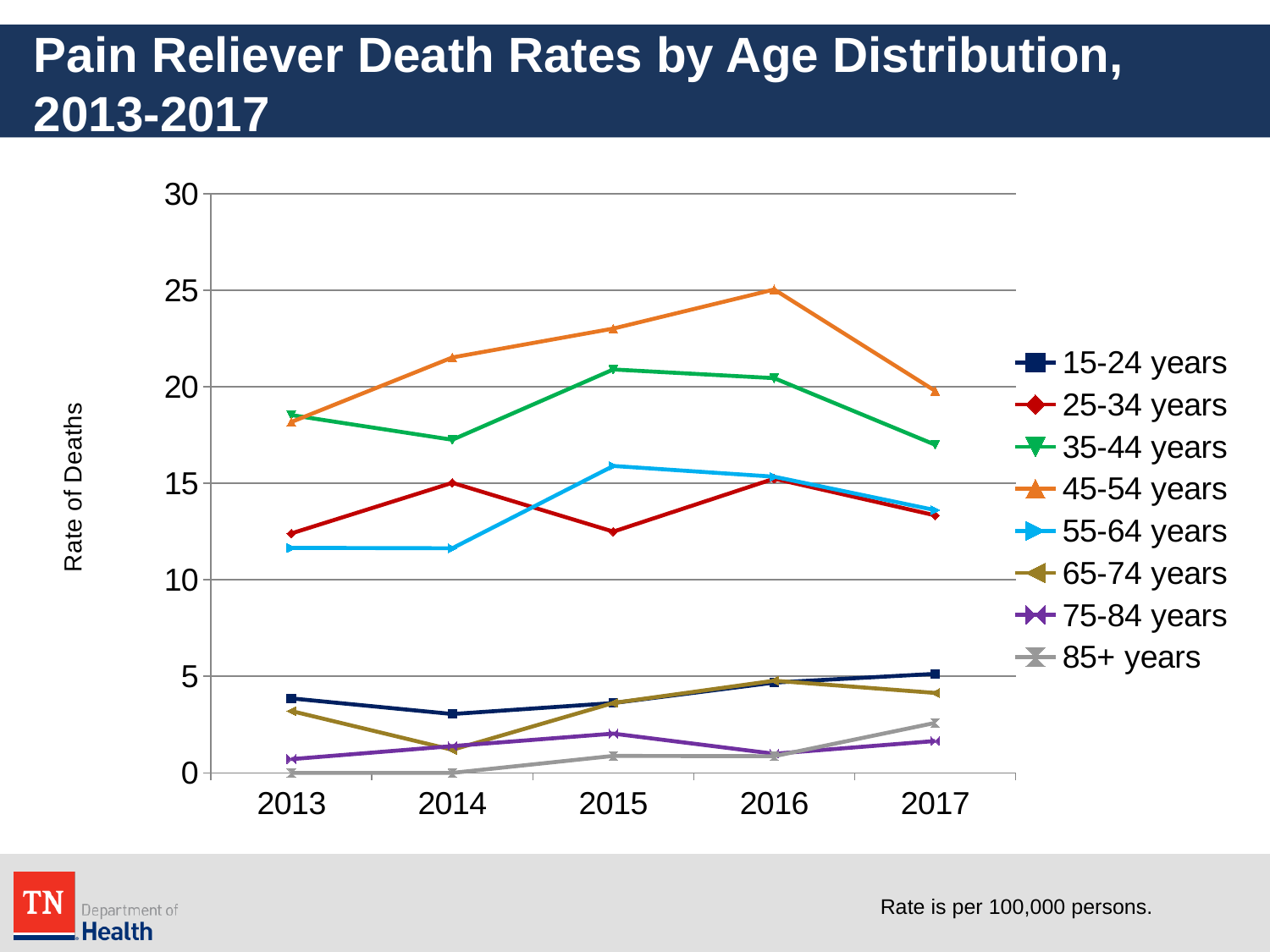
In 2015, which is larger: the rate for 35-44 years or the rate for 25-34 years? 35-44 years Is the value for the 55-64 years group in 2013 greater or less than 10? greater What is the label on the y axis? Rate of Deaths Which age group has the lowest rate of deaths in 2013? 85+ years Which age group has the highest rate of deaths in 2016? 45-54 years What kind of chart is shown on the slide? line chart How many series does the legend list? 8 Is the value for the 65-74 years group in 2014 greater or less than 5? less Does the rate for the 45-54 years group rise or fall from 2013 to 2016? rise How many years are plotted along the x axis? 5 Is the value for the 35-44 years group in 2015 greater or less than 20? greater